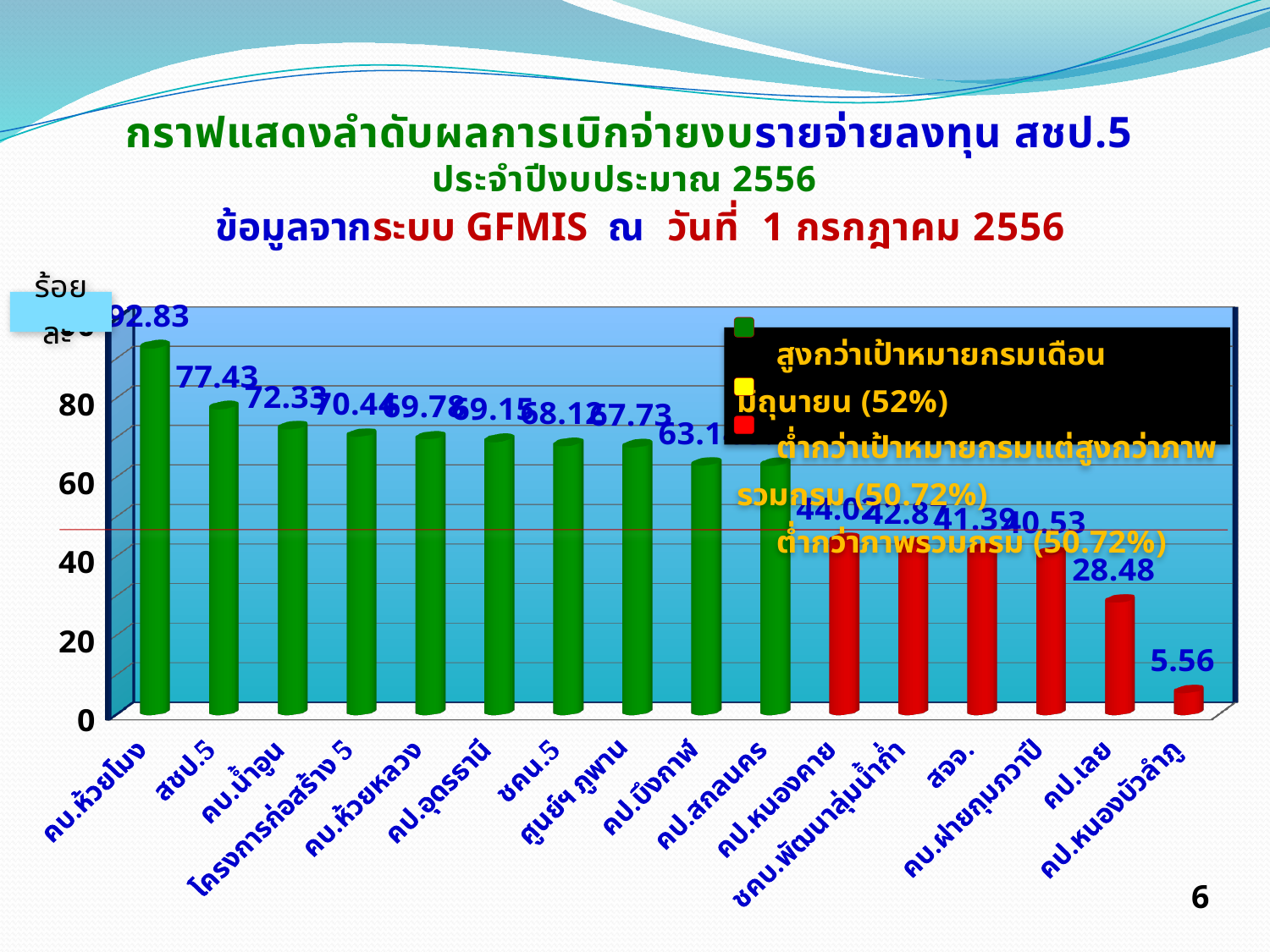
What is the value for คป.เลย? 28.48 What is the value for คป.หนองบัวลำภู? 5.56 What kind of chart is shown on the slide? Bar chart What is the value for สชป.5? 77.43 Which is larger, the value for สชป.5 or the value for คป.เลย? สชป.5 Which category has the highest value? คบ.ห้วยโมง What is the value for คบ.ห้วยโมง? 92.83 Which category has the lowest value? คป.หนองบัวลำภู What is the difference between the values for คบ.ห้วยโมง and คป.หนองบัวลำภู? 87.27 Do the values rise or fall from left to right along the x axis? Fall Is the value for คป.สกลนคร greater or less than 40? greater How many categories are shown on the x axis? 16